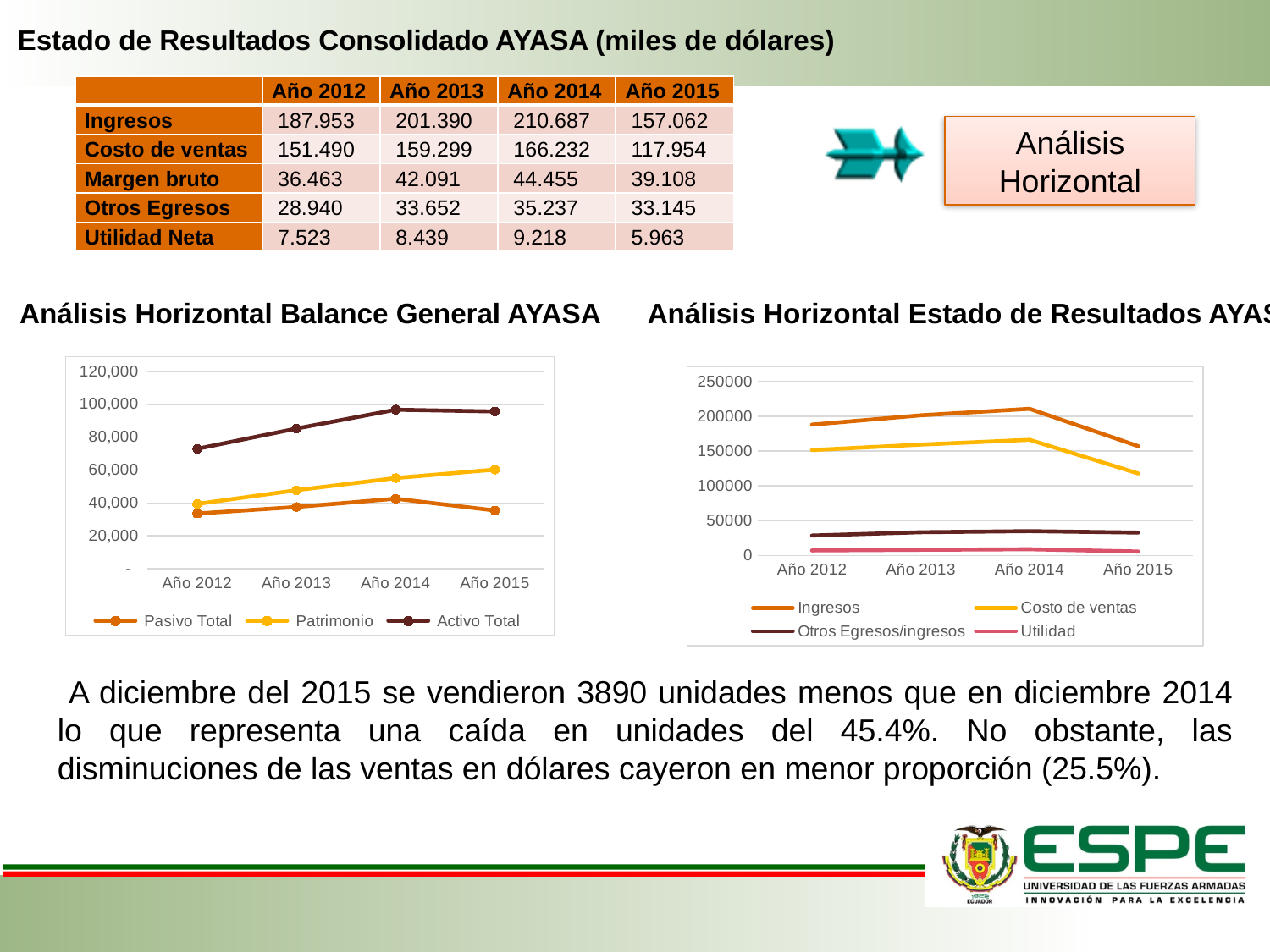
How many years are shown on the x axis of the 'Análisis Horizontal Balance General AYASA' chart? 4 In the 'Análisis Horizontal Balance General AYASA' chart, which series has the highest values across all years? Activo Total How many series does the legend of the 'Análisis Horizontal Estado de Resultados AYASA' chart list? 4 In the 'Análisis Horizontal Balance General AYASA' chart, is the value of Pasivo Total in Año 2015 greater or less than 40,000? less In the 'Análisis Horizontal Estado de Resultados AYASA' chart, does Costo de ventas rise or fall from Año 2014 to Año 2015? fall In the 'Análisis Horizontal Estado de Resultados AYASA' chart, which series has the lowest values? Utilidad In the 'Análisis Horizontal Estado de Resultados AYASA' chart, is the value of Ingresos in Año 2015 greater or less than 200000? less In the 'Análisis Horizontal Balance General AYASA' chart, is the value of Activo Total in Año 2012 greater or less than 60,000? greater In the 'Análisis Horizontal Balance General AYASA' chart, does Patrimonio rise or fall from Año 2012 to Año 2015? rise How many series does the legend of the 'Análisis Horizontal Balance General AYASA' chart list? 3 What kind of chart is the 'Análisis Horizontal Balance General AYASA' chart? line chart In the 'Análisis Horizontal Balance General AYASA' chart, which is larger in Año 2015: Patrimonio or Pasivo Total? Patrimonio